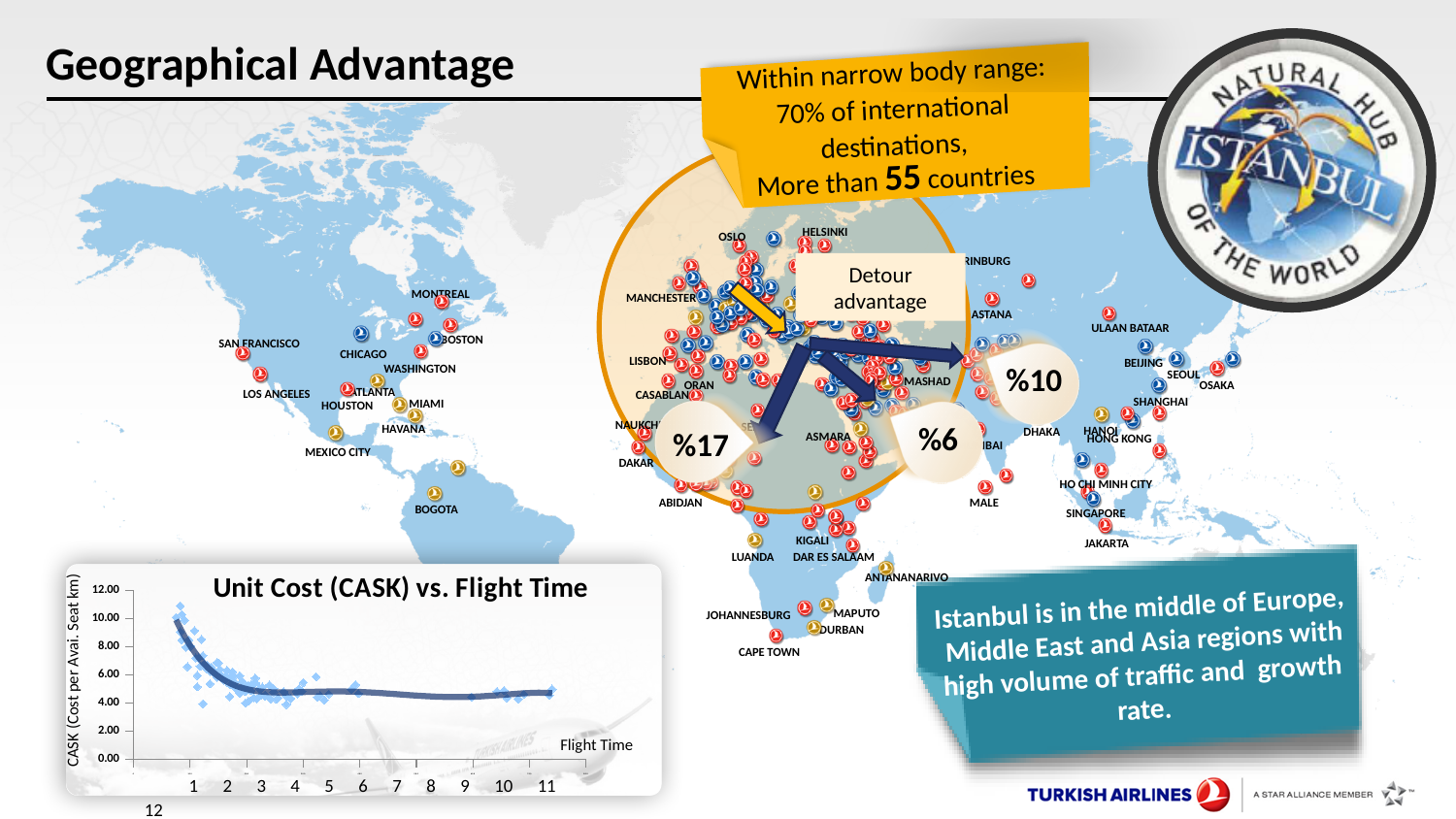
In the "Unit Cost (CASK) vs. Flight Time" chart, is the CASK value at a flight time of 5 greater or less than 8.00? less In the "Unit Cost (CASK) vs. Flight Time" chart, how many numbered ticks are shown on the Flight Time axis? 11 In the "Unit Cost (CASK) vs. Flight Time" chart, what is the highest value shown on the vertical axis? 12.00 In the "Unit Cost (CASK) vs. Flight Time" chart, what is the label of the vertical axis? CASK (Cost per Avai. Seat km) In the "Unit Cost (CASK) vs. Flight Time" chart, is the CASK value at a flight time of 10 greater or less than 6.00? less What is the title of the chart at the bottom left of the slide? Unit Cost (CASK) vs. Flight Time What kind of chart is "Unit Cost (CASK) vs. Flight Time"? scatter chart In the "Unit Cost (CASK) vs. Flight Time" chart, do CASK values rise or fall as flight time increases? fall In the "Unit Cost (CASK) vs. Flight Time" chart, is the CASK value at a flight time of 1 greater or less than 8.00? greater